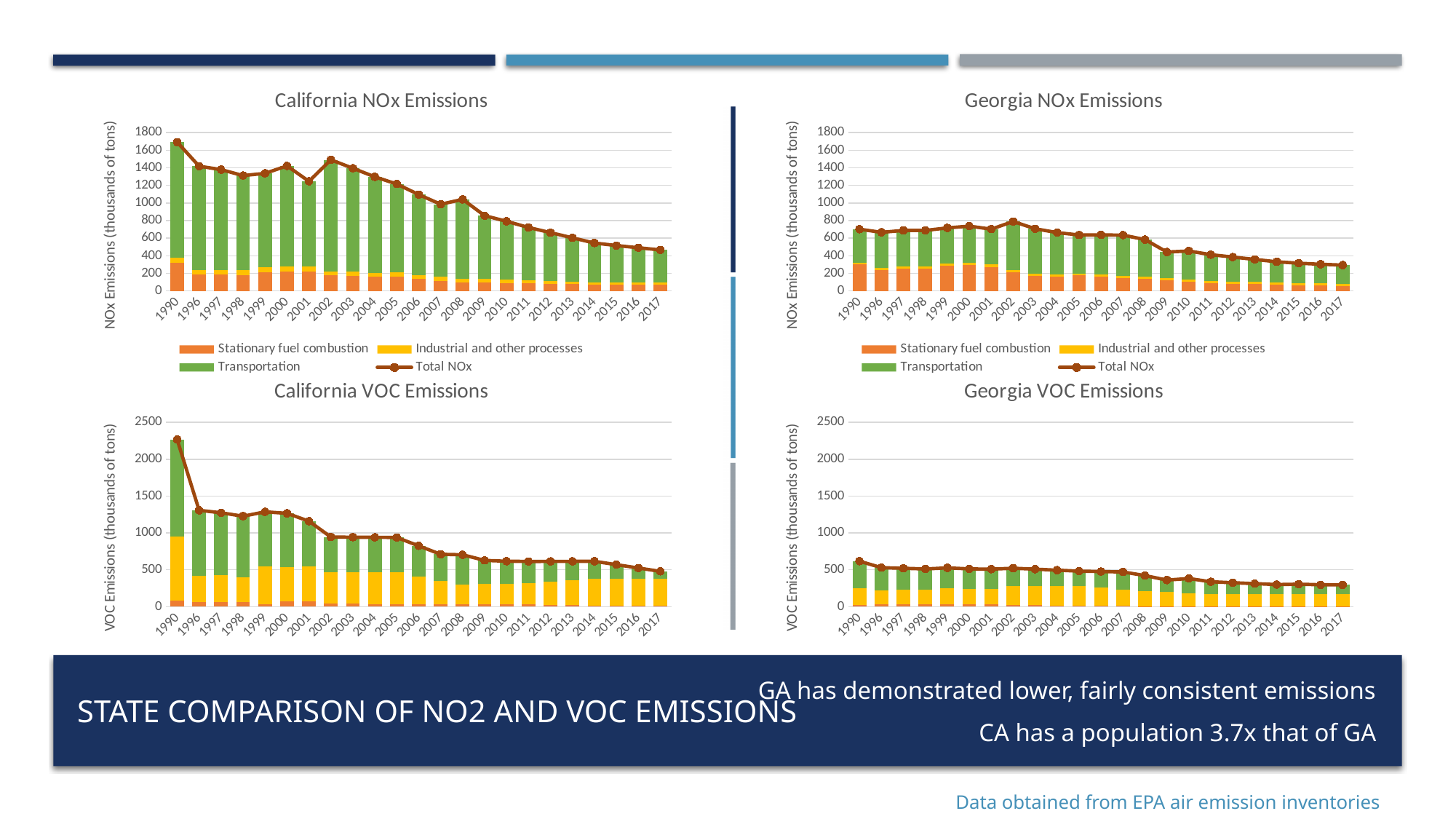
How many series does the legend of the Georgia NOx Emissions chart list? 4 In the Georgia VOC Emissions chart, is the total for 2017 greater or less than 500? less In the California VOC Emissions chart, is the total for 1990 greater or less than 2000? greater In the California NOx Emissions chart, how many years are shown on the x axis? 23 In the Georgia NOx Emissions chart, do Total NOx values generally rise or fall from 1990 to 2017? fall What kind of chart is the California NOx Emissions chart? stacked bar chart with a line In the Georgia NOx Emissions chart, which year has the highest Total NOx? 2002 In the California VOC Emissions chart, which year has the highest total? 1990 In the California NOx Emissions chart, which is larger, the Total NOx for 2001 or for 2002? 2002 In the California NOx Emissions chart, is the Total NOx for 1990 greater or less than 1600? greater In the California NOx Emissions chart, which colour represents Transportation? green In the California NOx Emissions chart, which year has the highest Total NOx? 1990